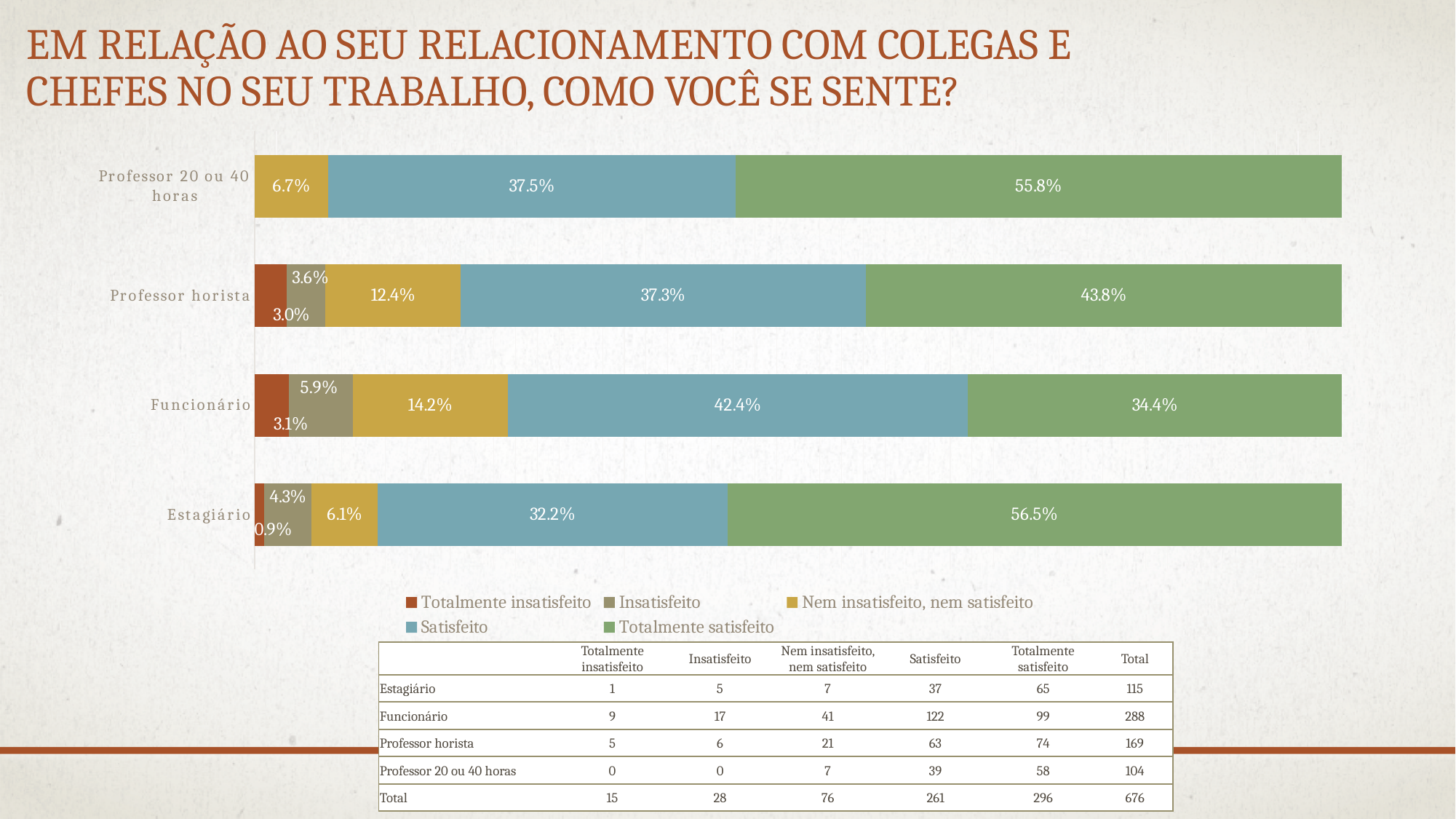
Which category has the lowest Satisfeito value? Estagiário What is the Satisfeito value for Funcionário? 42.4% Which has a larger Totalmente satisfeito value, Professor horista or Funcionário? Professor horista Which colour represents Totalmente satisfeito in the legend? Green How many series does the legend list? 5 What kind of chart is shown on the slide? Stacked bar chart What is the Nem insatisfeito, nem satisfeito value for Professor horista? 12.4% What percentage of Professor 20 ou 40 horas respondents answered Totalmente satisfeito? 55.8% How many categories are shown on the chart? 4 Which category has the highest Satisfeito value? Funcionário What is the Totalmente insatisfeito value for Estagiário? 0.9% For Funcionário, what is the difference between the Satisfeito and Totalmente satisfeito values? 8.0%